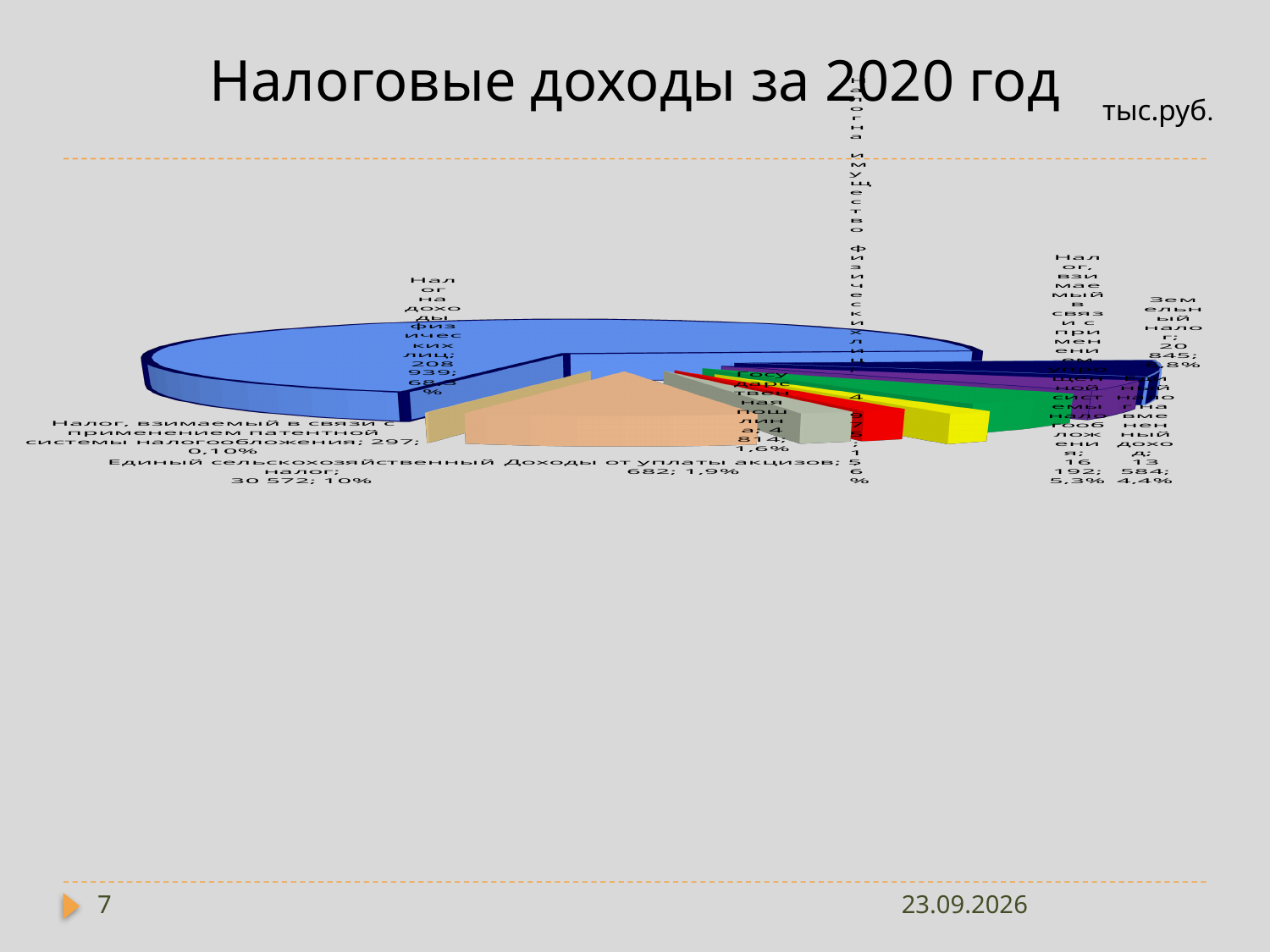
What is the value for Земельный налог? 20 845 What is the value for Единый сельскохозяйственный налог? 30 572 What share of the pie does Земельный налог have? 6,8% Which category has the smallest slice of the pie? Налог, взимаемый в связи с применением патентной системы налогообложения What is the value for Налог, взимаемый в связи с применением патентной системы налогообложения? 297 What is the title of the chart? Налоговые доходы за 2020 год What kind of chart is shown on the slide? pie chart What is the value for Налог, взимаемый в связи с применением упрощенной системы налогообложения? 16 192 What is the difference between the values for Земельный налог and Единый налог на вмененный доход? 7 261 Which category has the largest slice of the pie? Налог на доходы физических лиц What share of the pie does Единый сельскохозяйственный налог have? 10% In what units are the values on the chart given? тыс.руб.